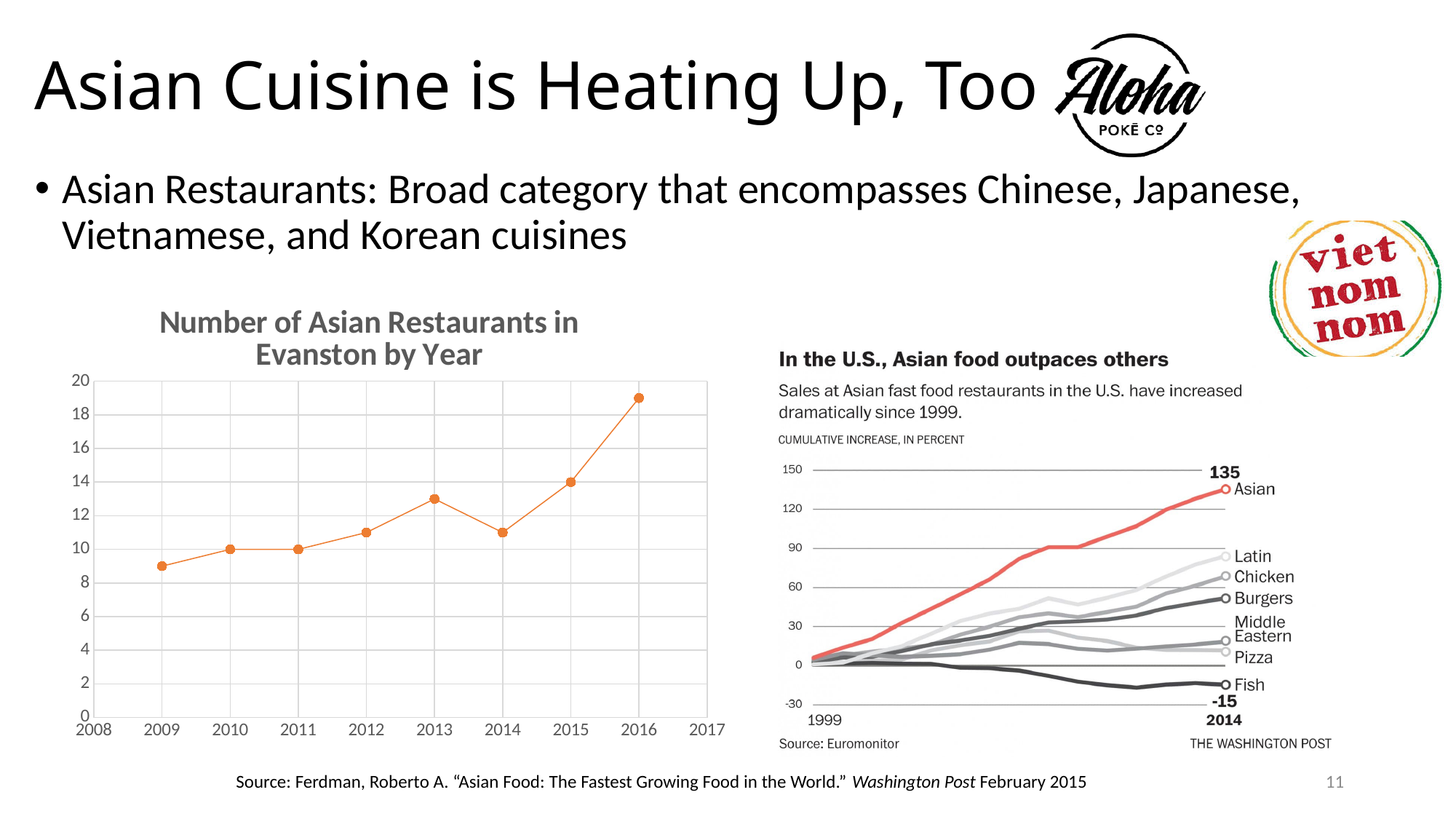
In the 'Number of Asian Restaurants in Evanston by Year' chart, how many data points are plotted? 8 In the 'In the U.S., Asian food outpaces others' chart, what is the cumulative increase for Asian in 2014? 135 In the 'Number of Asian Restaurants in Evanston by Year' chart, which year has the highest value? 2016 In the 'In the U.S., Asian food outpaces others' chart, how many food categories are plotted? 7 In the 'In the U.S., Asian food outpaces others' chart, what is the difference between the 2014 values for Asian and Fish? 150 In the 'Number of Asian Restaurants in Evanston by Year' chart, what is the value for 2010? 10 What kind of chart is the 'Number of Asian Restaurants in Evanston by Year' chart? line chart In the 'Number of Asian Restaurants in Evanston by Year' chart, which year has the lowest value? 2009 In the 'Number of Asian Restaurants in Evanston by Year' chart, do the values generally rise or fall from 2009 to 2016? rise In the 'Number of Asian Restaurants in Evanston by Year' chart, what is the value for 2015? 14 In the 'In the U.S., Asian food outpaces others' chart, what is the value for Fish in 2014? -15 In the 'Number of Asian Restaurants in Evanston by Year' chart, is the value for 2016 greater or less than 18? greater